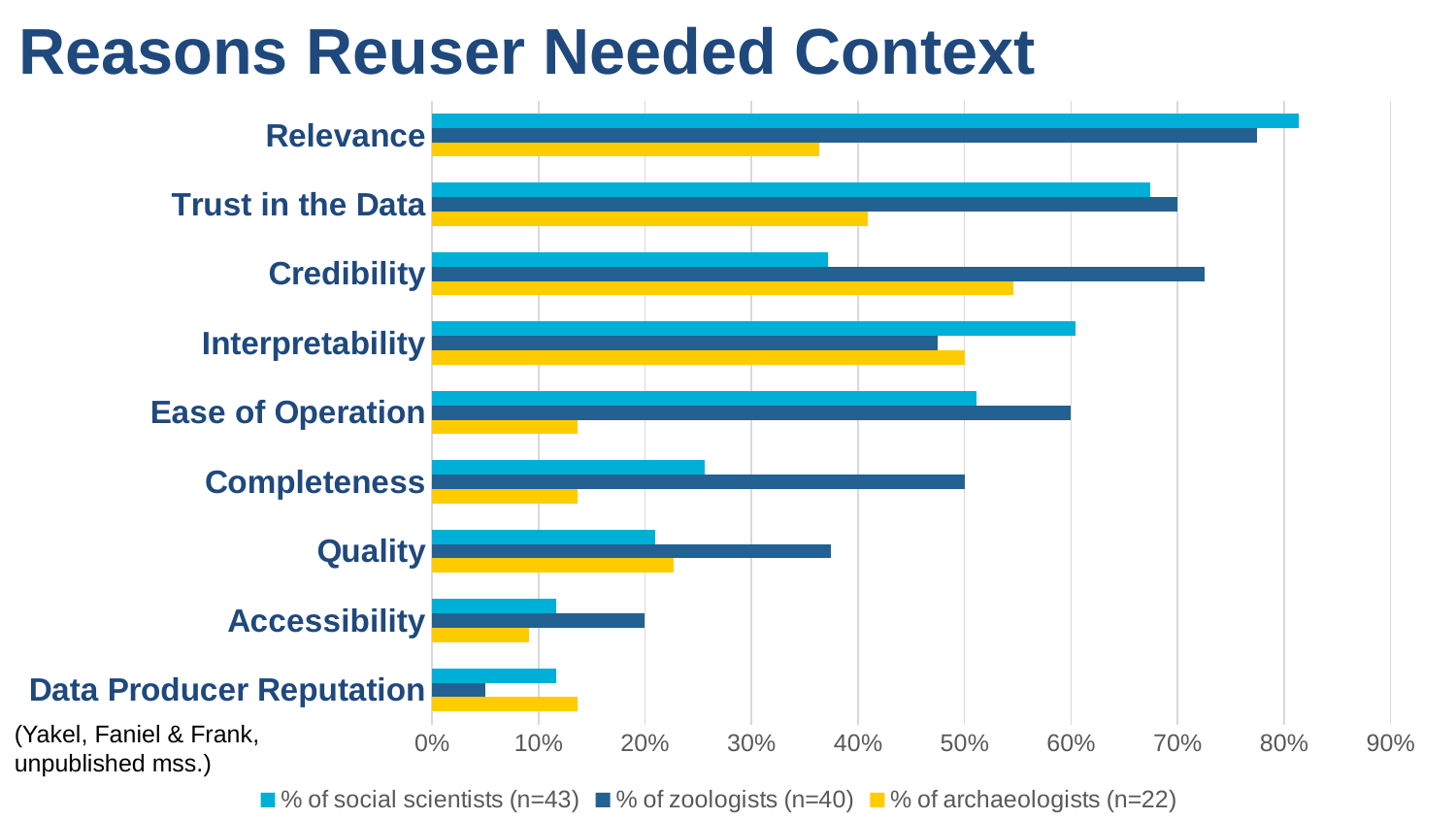
How many reason categories are plotted on the chart? 9 What kind of chart is shown on the slide? bar chart How many series does the legend list? 3 What is the title of the chart? Reasons Reuser Needed Context Is the value for % of zoologists (n=40) for Credibility greater or less than 70%? greater Which category has the highest value for % of social scientists (n=43)? Relevance Is the value for % of social scientists (n=43) for Interpretability greater or less than 50%? greater Which category has the lowest value for % of zoologists (n=40)? Data Producer Reputation Is the value for % of archaeologists (n=22) for Ease of Operation greater or less than 20%? less Which category has the highest value for % of archaeologists (n=22)? Credibility For Completeness, which is larger: % of social scientists (n=43) or % of zoologists (n=40)? % of zoologists (n=40) For Credibility, which is larger: % of zoologists (n=40) or % of social scientists (n=43)? % of zoologists (n=40)